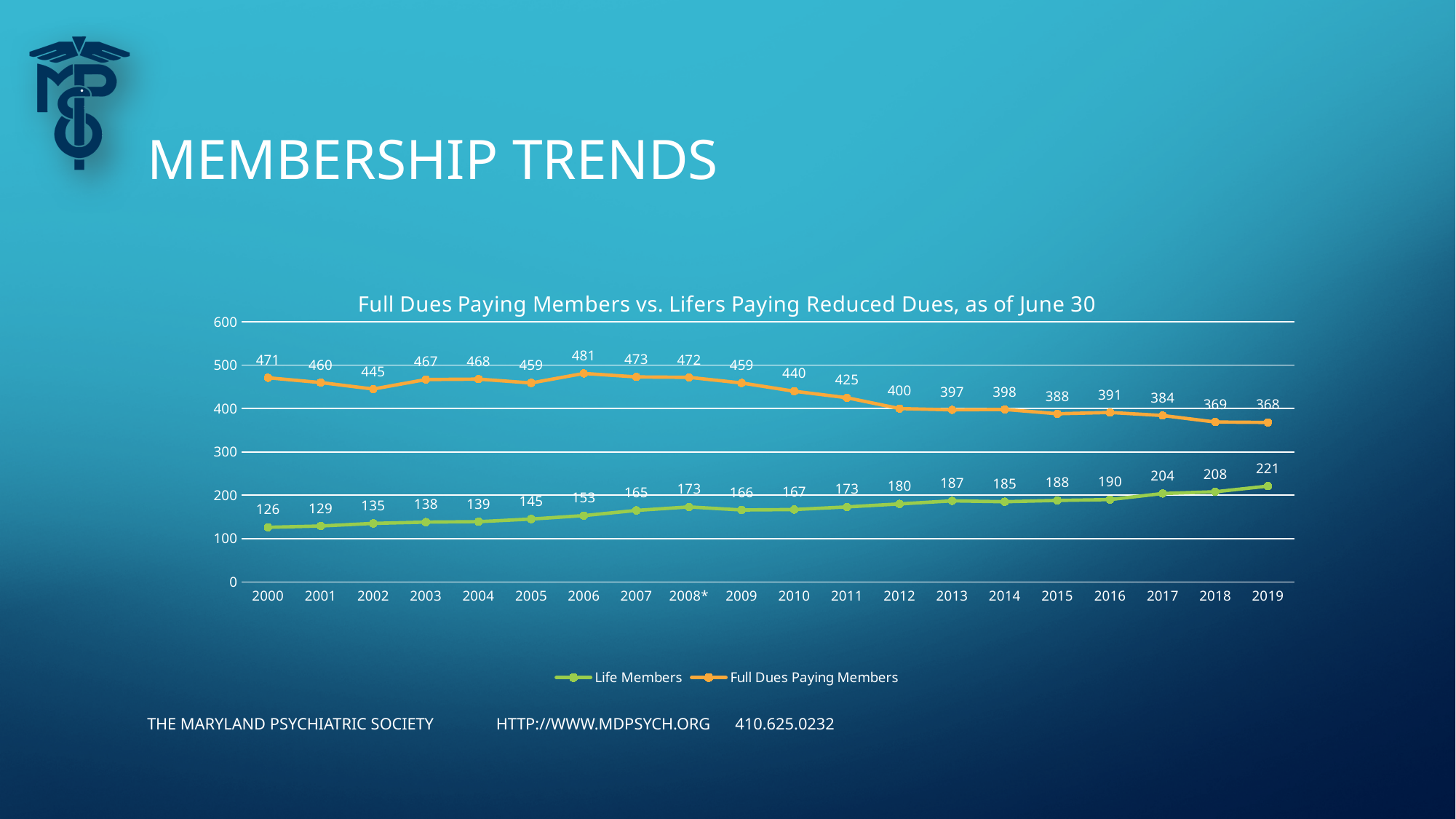
What is the value for Life Members in 2019? 221 In which year is the Life Members value lowest? 2000 Which is larger: Life Members in 2017 or Life Members in 2012? Life Members in 2017 How many series does the legend list? 2 What is the difference between Full Dues Paying Members and Life Members in 2019? 147 In which year is the Full Dues Paying Members value highest? 2006 What kind of chart is shown on the slide? Line chart What is the value for Full Dues Paying Members in 2006? 481 Do the Full Dues Paying Members values generally rise or fall from 2006 to 2019? Fall How many years are shown on the x axis? 20 In which year is the Full Dues Paying Members value lowest? 2019 What is the value for Life Members in 2000? 126